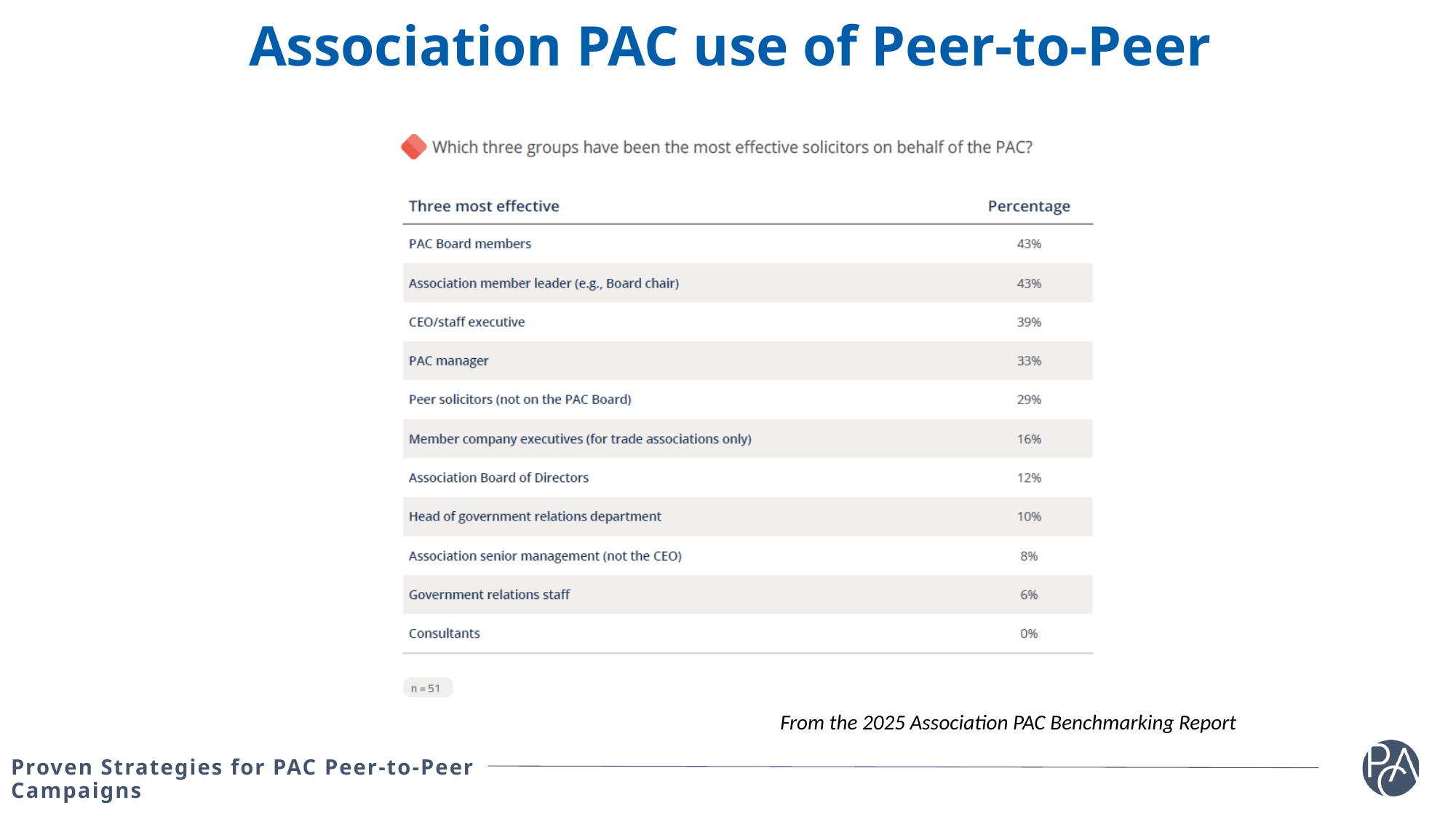
What question does the table answer, as shown above it? Which three groups have been the most effective solicitors on behalf of the PAC? In the table, what percentage is shown for CEO/staff executive? 39% What is the difference in percentage between CEO/staff executive and Association Board of Directors? 27% In the table, what percentage is shown for Peer solicitors (not on the PAC Board)? 29% Which has a higher percentage in the table: Member company executives (for trade associations only) or Association senior management (not the CEO)? Member company executives (for trade associations only) What is the difference in percentage between PAC manager and Head of government relations department? 23% What is the sample size (n) shown below the table? n = 51 In the table, what percentage is shown for Government relations staff? 6% In the table, what percentage is shown for PAC Board members? 43% How many groups are listed in the table? 11 Which group in the table has the lowest percentage? Consultants Which has a higher percentage in the table: PAC manager or Peer solicitors (not on the PAC Board)? PAC manager